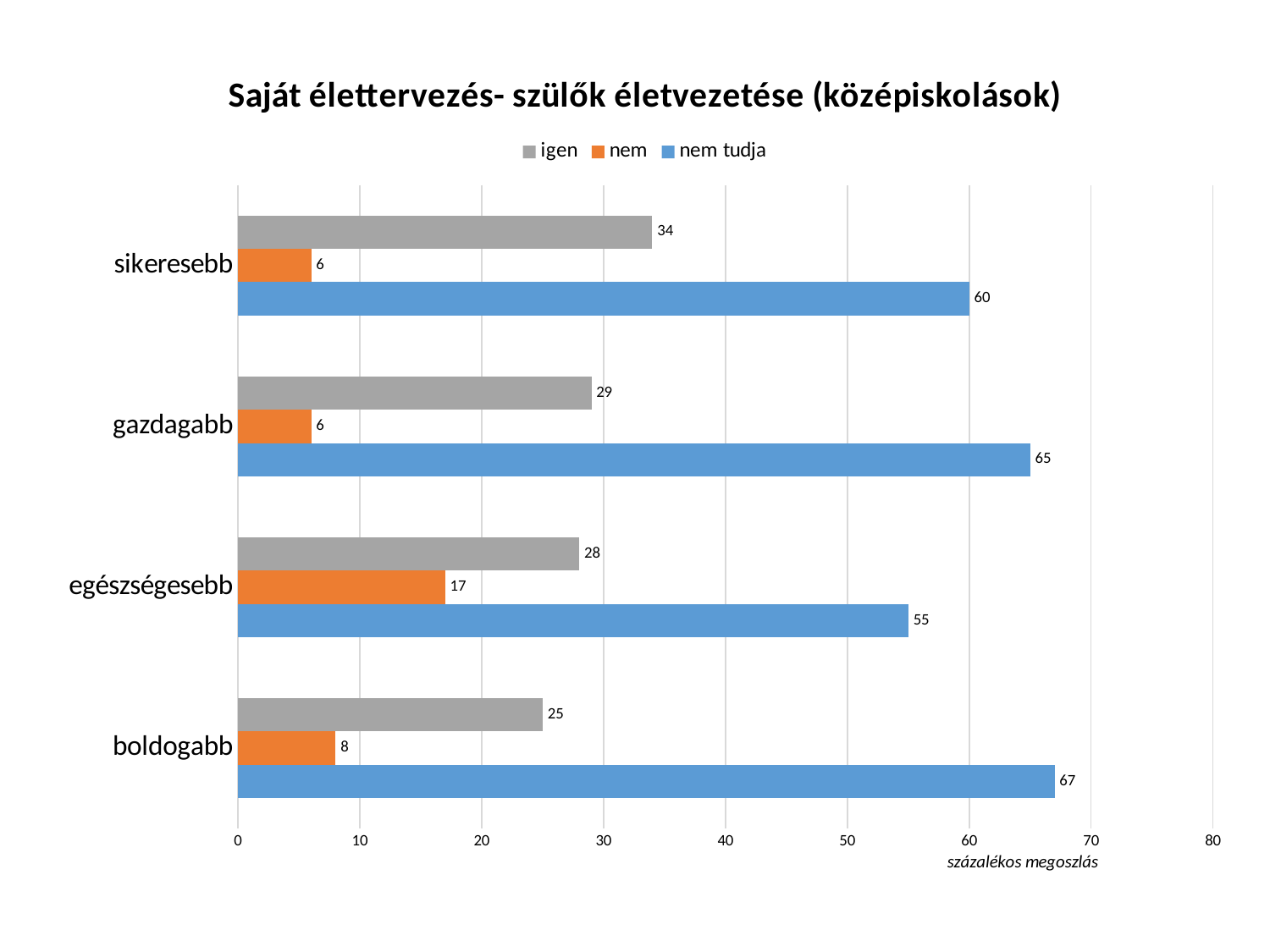
How many categories are shown on the chart? 4 What is the title of the chart? Saját élettervezés- szülők életvezetése (középiskolások) What is the value of "nem tudja" for "boldogabb"? 67 What is the value of "igen" for "sikeresebb"? 34 Which is larger: the "igen" value for "sikeresebb" or the "igen" value for "egészségesebb"? sikeresebb How many series does the legend list? 3 What is the value of "nem" for "egészségesebb"? 17 Which category has the lowest "igen" value? boldogabb Which category has the highest "nem tudja" value? boldogabb Is the "nem tudja" value for "egészségesebb" greater or less than 60? less What is the difference between the "nem tudja" value for "gazdagabb" and the "igen" value for "gazdagabb"? 36 What kind of chart is shown on the slide? bar chart